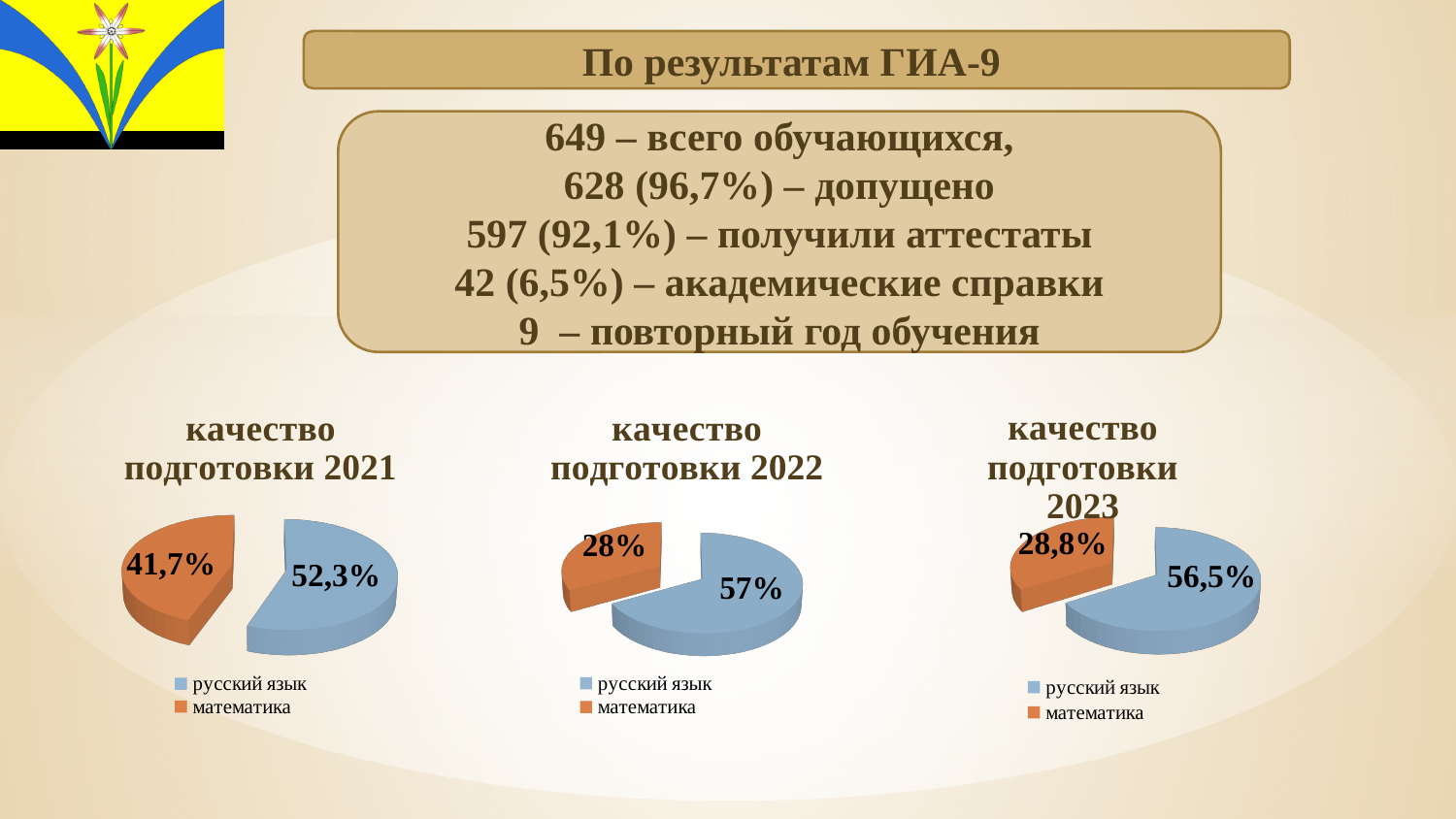
In the chart titled "качество подготовки 2023", what is the value for математика? 28,8% In the chart titled "качество подготовки 2021", what is the value for математика? 41,7% In the chart titled "качество подготовки 2021", what is the value for русский язык? 52,3% In the chart titled "качество подготовки 2021", what colour is the slice for математика? orange In the chart titled "качество подготовки 2023", what is the value for русский язык? 56,5% In the chart titled "качество подготовки 2023", what is the difference between the values for русский язык and математика? 27,7% In the chart titled "качество подготовки 2022", what is the difference between the values for русский язык and математика? 29% In the chart titled "качество подготовки 2022", what is the value for математика? 28% In the chart titled "качество подготовки 2022", what is the value for русский язык? 57% In the chart titled "качество подготовки 2021", which category has the larger value, русский язык or математика? русский язык How many categories does the chart titled "качество подготовки 2023" show? 2 What kind of chart is the chart titled "качество подготовки 2022"? pie chart